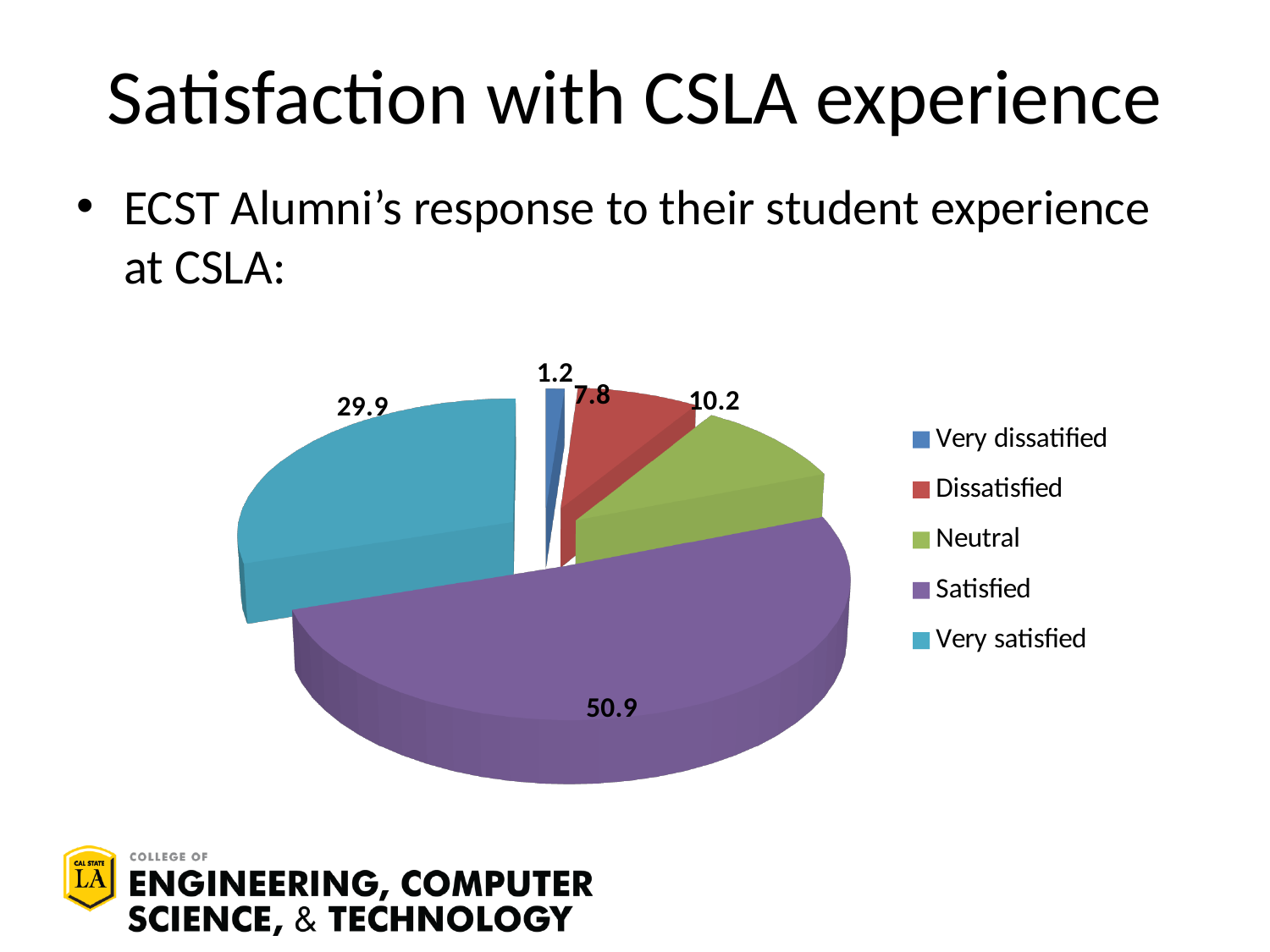
What colour is the Satisfied slice in the pie chart? Purple Which is larger, the Neutral slice or the Dissatisfied slice? Neutral What is the difference between the Satisfied and Very satisfied values? 21.0 Which category has the smallest slice of the pie? Very dissatified What value is shown for the Very satisfied slice? 29.9 What is the difference between the Neutral and Dissatisfied values? 2.4 What value is shown for the Satisfied slice? 50.9 What value is shown for the Neutral slice? 10.2 What kind of chart is shown on the slide? Pie chart How many categories does the pie chart show? 5 What value is shown for the Dissatisfied slice? 7.8 Which category has the largest slice of the pie? Satisfied